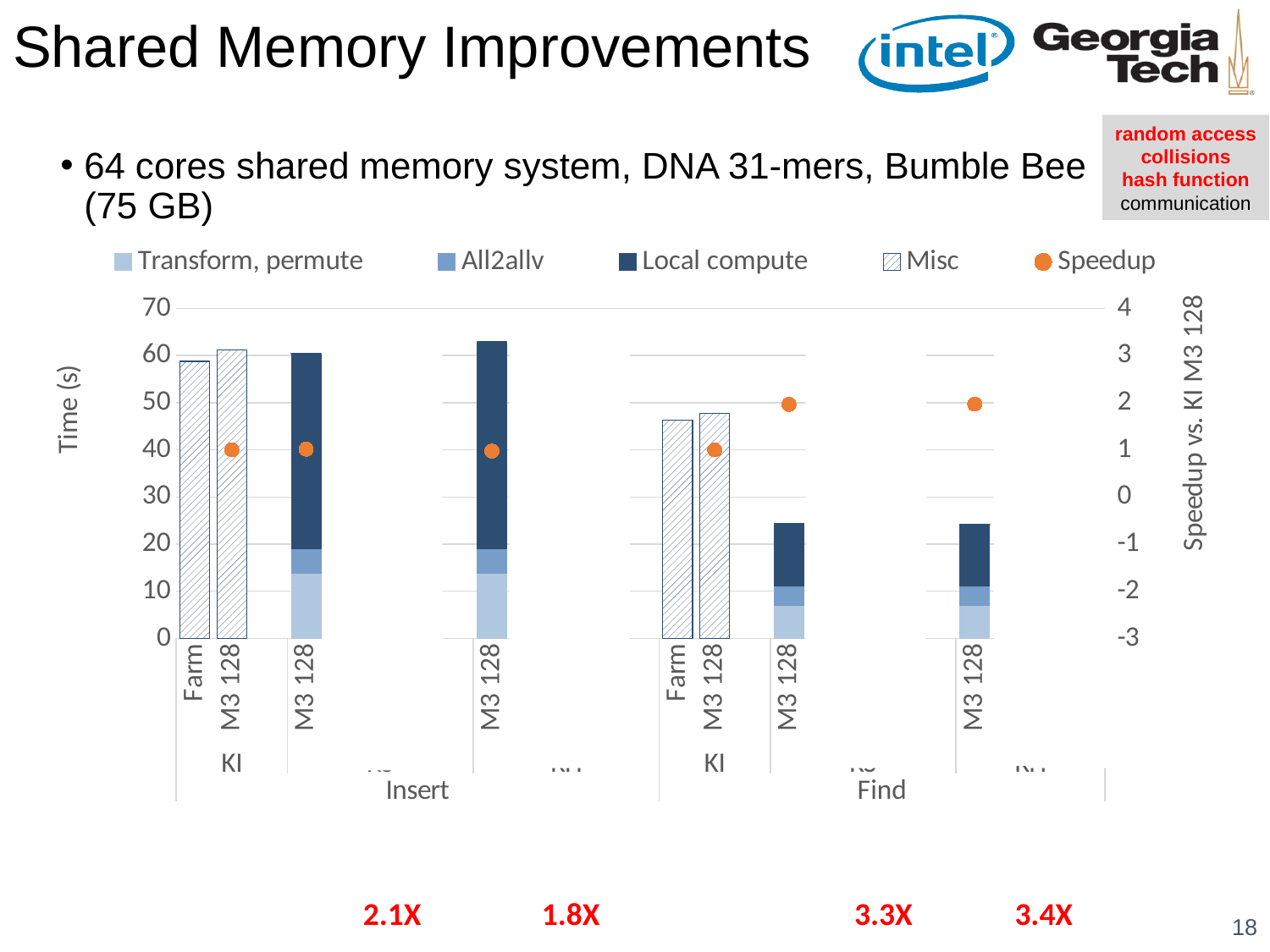
What is the label of the right vertical axis? Speedup vs. KI M3 128 How many bars are plotted in the Insert group? 4 Is the time for the third bar (M3 128) in the Find group greater or less than 30? less Is the Speedup value for the third bar (M3 128) in the Find group greater or less than 1? greater What kind of chart is shown on the slide? bar chart How many series does the chart legend list? 5 Is the time for the fourth bar (M3 128) in the Insert group greater or less than 60? greater Which is larger: the time for the third bar (M3 128) in the Insert group or the third bar (M3 128) in the Find group? Insert Which is larger: the time for the Farm bar under KI in the Insert group or the Farm bar under KI in the Find group? Insert What is the label of the left vertical axis? Time (s)